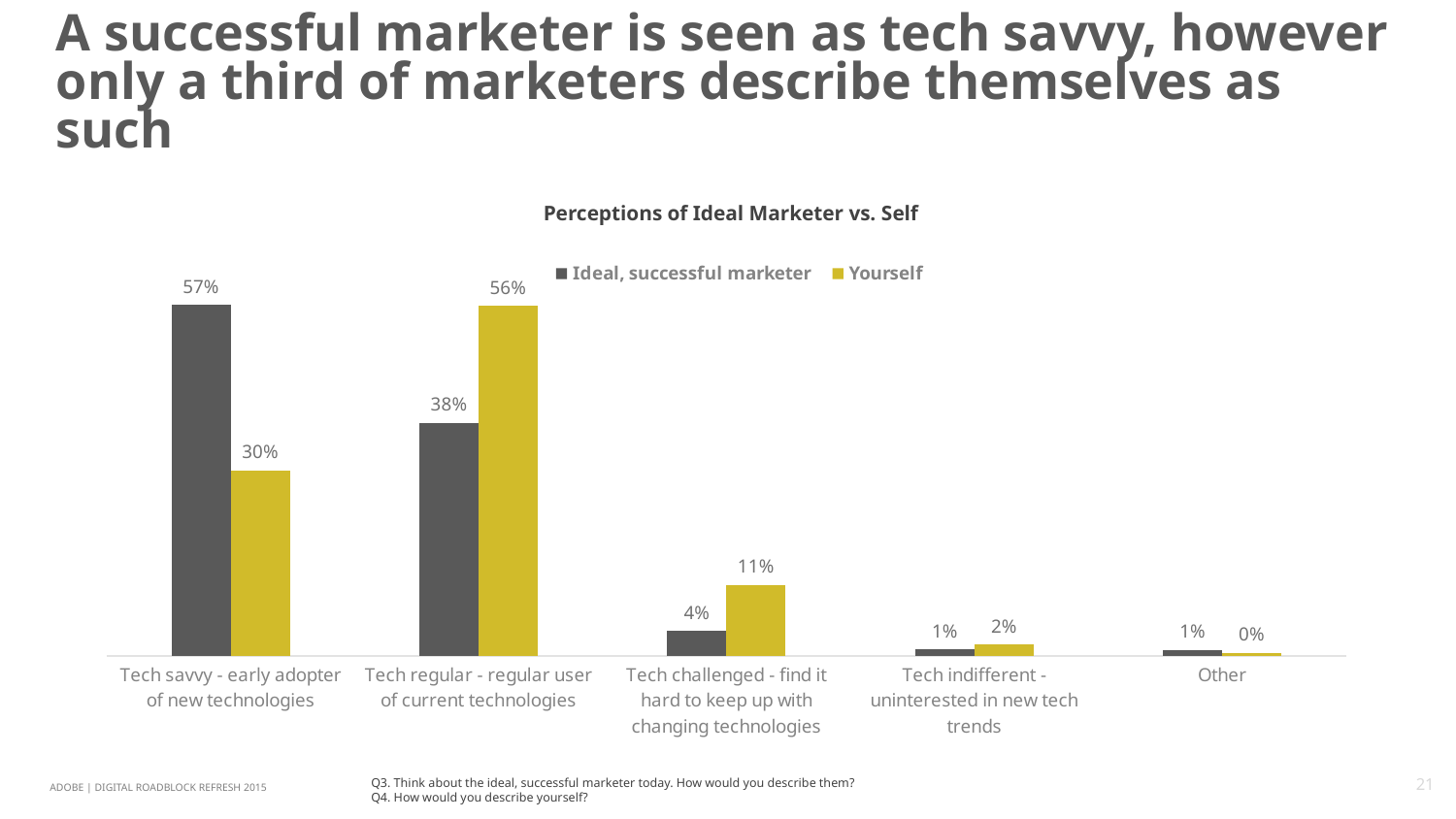
What is the difference between the 'Yourself' and 'Ideal, successful marketer' values in the 'Tech challenged - find it hard to keep up with changing technologies' category? 7% What is the value for 'Yourself' in the 'Tech regular - regular user of current technologies' category? 56% In the 'Tech regular - regular user of current technologies' category, which series has the larger value? Yourself What is the difference between the 'Ideal, successful marketer' and 'Yourself' values in the 'Tech savvy - early adopter of new technologies' category? 27% What is the value for 'Yourself' in the 'Tech challenged - find it hard to keep up with changing technologies' category? 11% Which category has the highest value for the 'Ideal, successful marketer' series? Tech savvy - early adopter of new technologies How many categories are shown on the x axis? 5 How many series does the legend list? 2 Which category has the lowest value for the 'Yourself' series? Other What is the title of the chart? Perceptions of Ideal Marketer vs. Self What is the value for 'Ideal, successful marketer' in the 'Tech savvy - early adopter of new technologies' category? 57% What kind of chart is shown on the slide? Bar chart